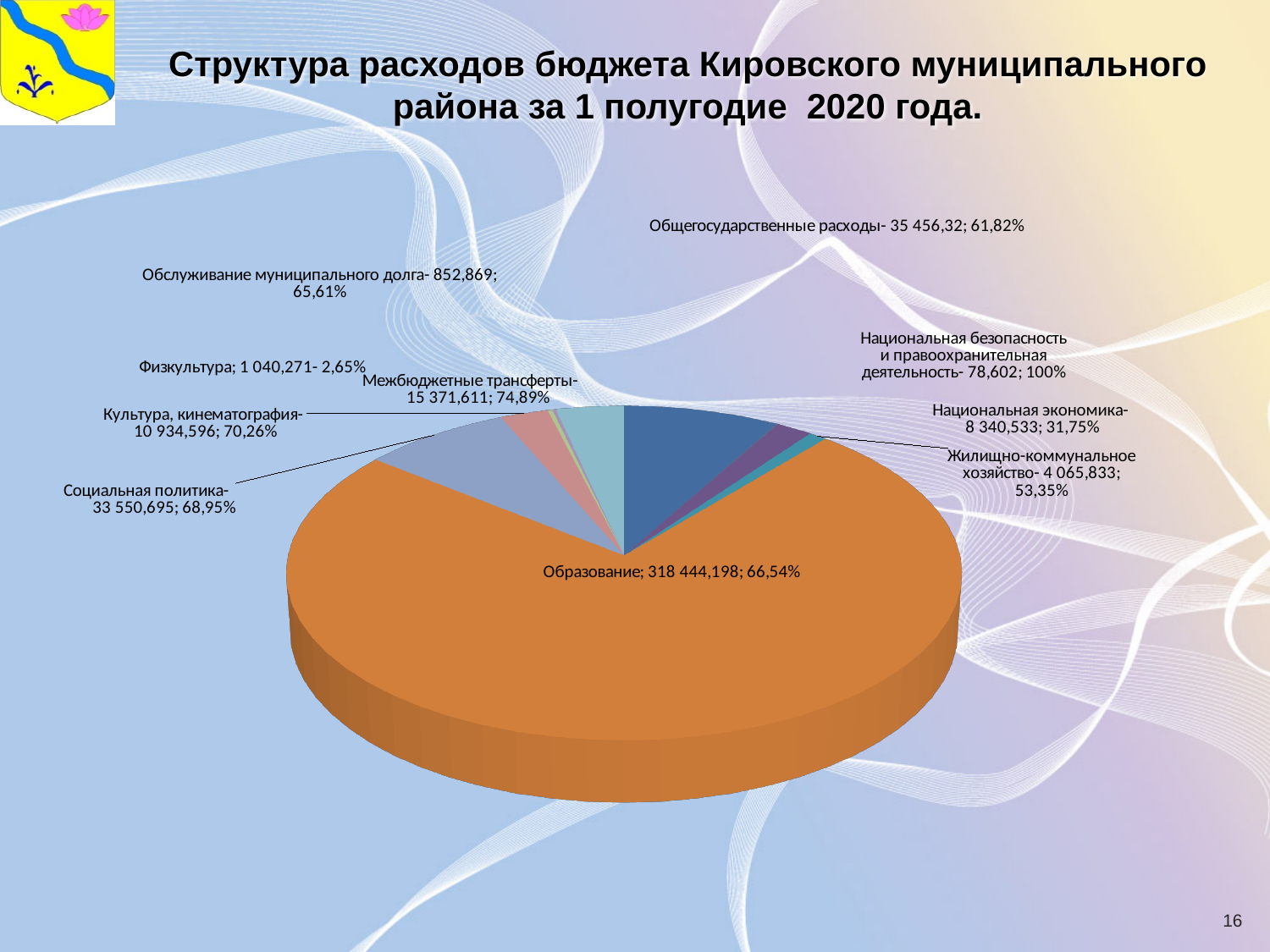
What is the difference between the values for Физкультура and Обслуживание муниципального долга? 187,402 What is the title of the chart on the slide? Структура расходов бюджета Кировского муниципального района за 1 полугодие 2020 года. What value is shown for Образование? 318 444,198 What kind of chart is shown on the slide? pie chart Which category has the largest slice of the pie? Образование How many categories (slices) does the pie chart have? 10 What value is shown for Социальная политика? 33 550,695 What value is shown for Межбюджетные трансферты? 15 371,611 Which is larger: the value for Общегосударственные расходы or the value for Социальная политика? Общегосударственные расходы What value is shown for Жилищно-коммунальное хозяйство? 4 065,833 What is the difference between the values for Межбюджетные трансферты and Культура, кинематография? 4 437,015 Which category has the smallest value in the chart? Национальная безопасность и правоохранительная деятельность